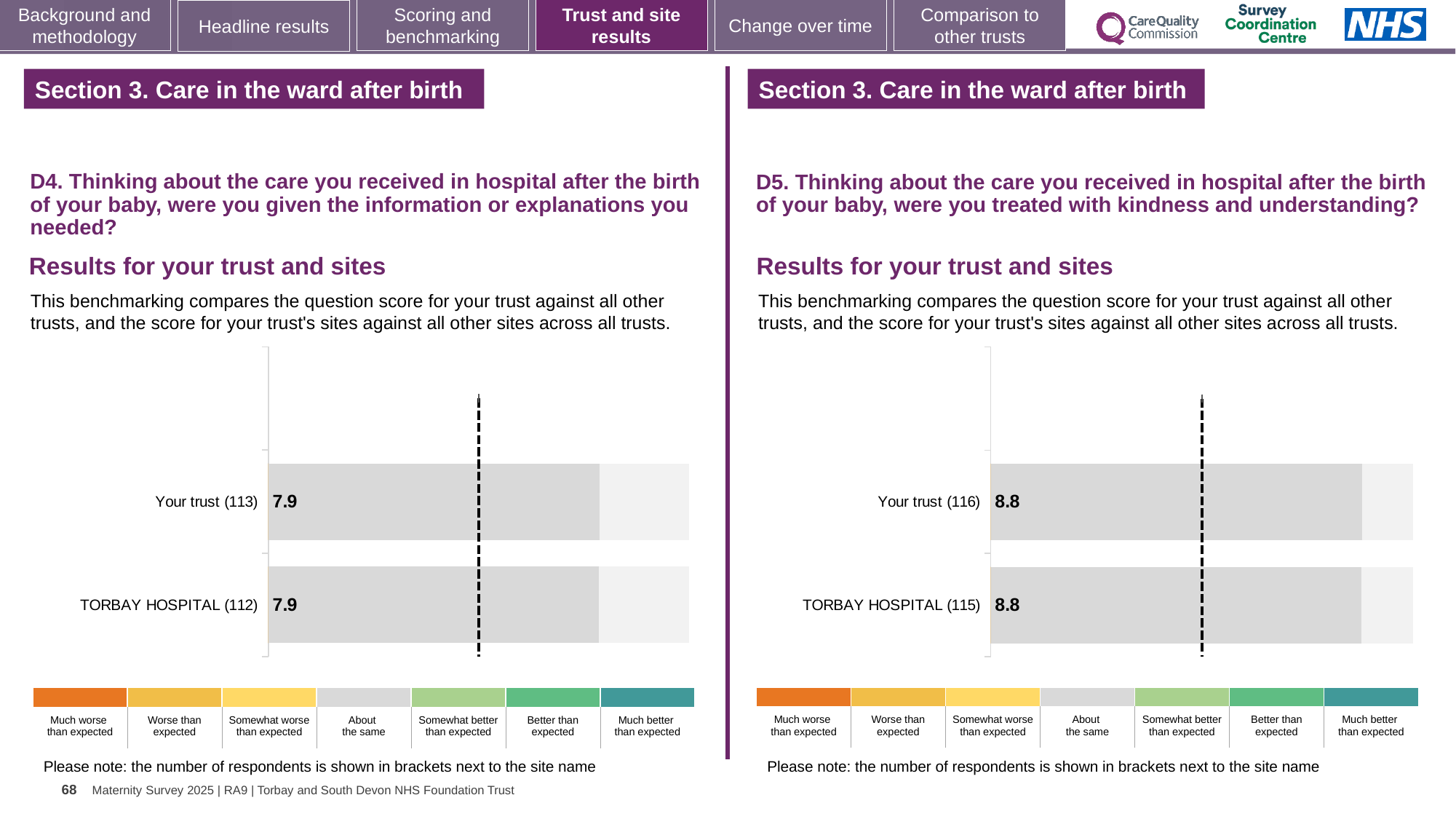
On the right chart (D5), what is the score for Your trust? 8.8 On the right chart (D5), what is the difference between the Your trust score and the TORBAY HOSPITAL score? 0 On the left chart (D4), what is the score for TORBAY HOSPITAL? 7.9 What kind of chart is used on the left (D4)? Bar chart How many bars are plotted on the left chart (D4)? 2 How many bars are plotted on the right chart (D5)? 2 On the right chart (D5), how many respondents are shown in brackets for TORBAY HOSPITAL? 115 Is the Your trust score on the right chart (D5) larger or smaller than the Your trust score on the left chart (D4)? Larger On the left chart (D4), what is the score for Your trust? 7.9 On the left chart (D4), how many respondents are shown in brackets for Your trust? 113 On the left chart (D4), what is the difference between the Your trust score and the TORBAY HOSPITAL score? 0 On the right chart (D5), what is the score for TORBAY HOSPITAL? 8.8